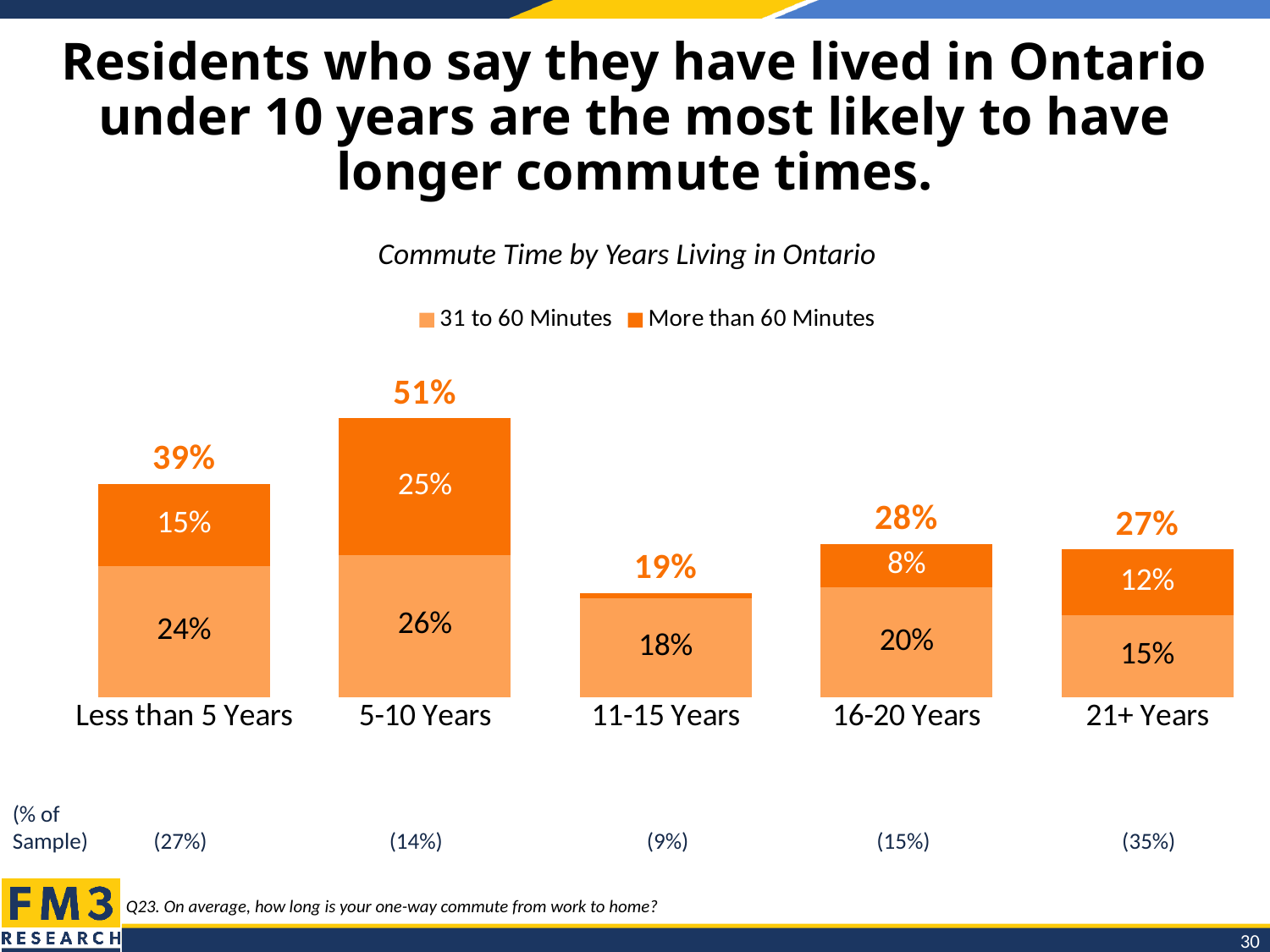
Which is larger: the '31 to 60 Minutes' value for Less than 5 Years or for 21+ Years? Less than 5 Years What kind of chart is shown on the slide? stacked bar chart What is the value for 'More than 60 Minutes' for residents living in Ontario 21+ Years? 12% What is the value for '31 to 60 Minutes' for residents living in Ontario 5-10 Years? 26% How many series does the legend list? 2 How many categories of years living in Ontario are shown on the x axis? 5 What is the difference between the 'More than 60 Minutes' values for 5-10 Years and 16-20 Years? 17% Which category has the lowest total share of residents with commutes over 30 minutes? 11-15 Years What is the total for the 16-20 Years bar? 28% What is the title of the chart? Commute Time by Years Living in Ontario What is the value for 'More than 60 Minutes' for residents living in Ontario Less than 5 Years? 15% Which category has the highest total share of residents with commutes over 30 minutes? 5-10 Years